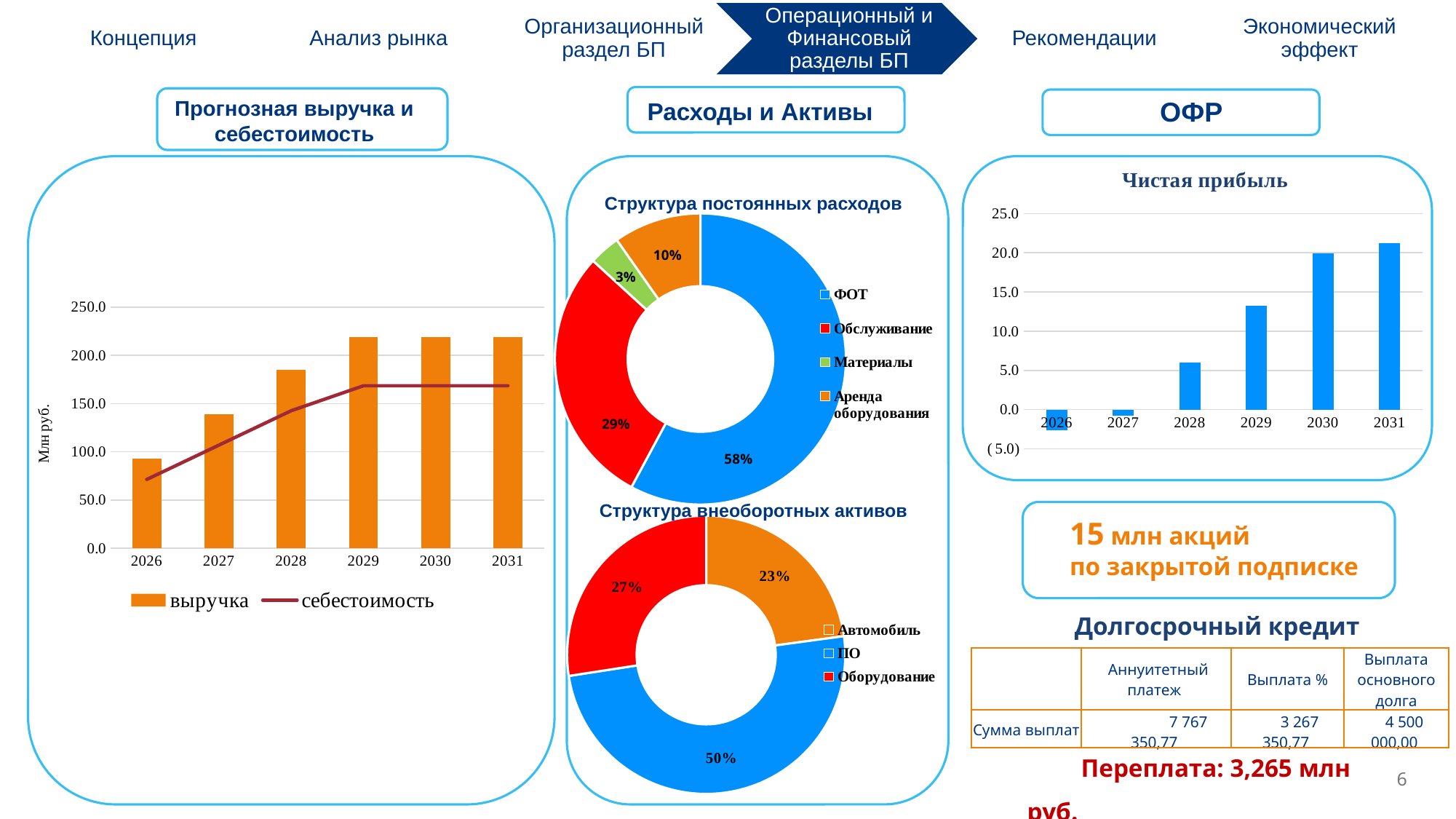
In the 'Структура постоянных расходов' donut chart, what share does Материалы have? 3% In the 'Структура постоянных расходов' donut chart, what share does ФОТ have? 58% In the 'Структура внеоборотных активов' donut chart, what share does ПО have? 50% In the 'Структура постоянных расходов' donut chart, which category has the largest share? ФОТ In the 'Структура внеоборотных активов' donut chart, which is larger: Автомобиль or Оборудование? Оборудование In the 'Чистая прибыль' chart, which year has the lowest value? 2026 In the 'Чистая прибыль' chart, is the value for 2029 greater or less than 10.0? greater In the 'Прогнозная выручка и себестоимость' chart, is the value of выручка for 2026 greater or less than 100? less How many series does the legend of the 'Прогнозная выручка и себестоимость' chart list? 2 In the 'Прогнозная выручка и себестоимость' chart, is the value of выручка for 2029 greater or less than 200? greater How many categories does the 'Структура внеоборотных активов' donut chart show? 3 In the 'Структура постоянных расходов' donut chart, what is the difference between the shares of Обслуживание and Аренда оборудования? 19%